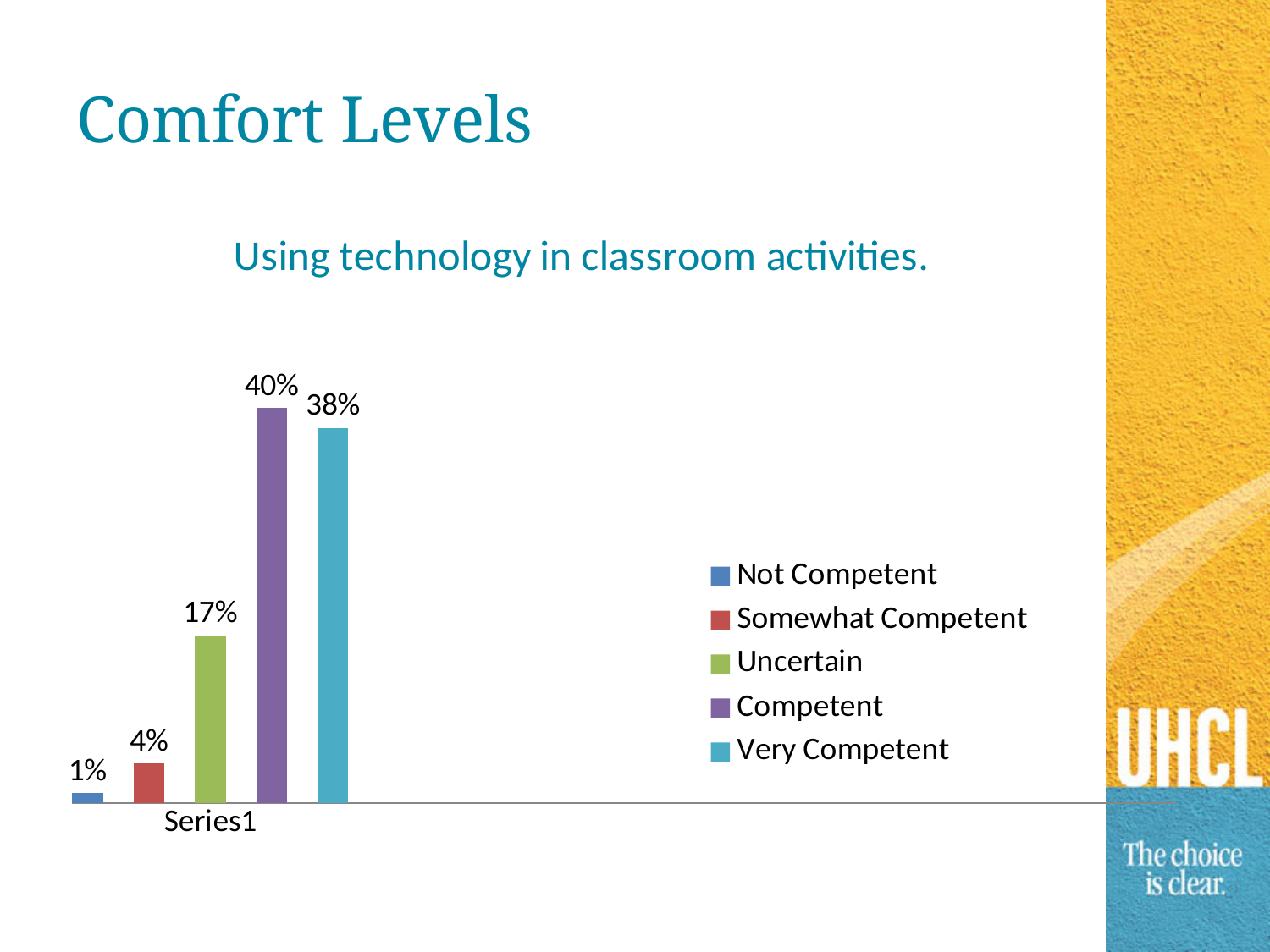
Which is larger, the value for Uncertain or the value for Somewhat Competent? Uncertain What is the value shown for Uncertain? 17% What is the difference in percentage points between Competent and Very Competent? 2% What is the value shown for Somewhat Competent? 4% What percentage of respondents reported being Competent at using technology in classroom activities? 40% Which comfort level has the lowest percentage? Not Competent What is the difference between the Uncertain and Somewhat Competent values? 13% What is the value shown for Not Competent? 1% How many series does the legend list? 5 What kind of chart is shown on the slide? Bar chart What is the value shown for Very Competent? 38% Which comfort level has the highest percentage? Competent